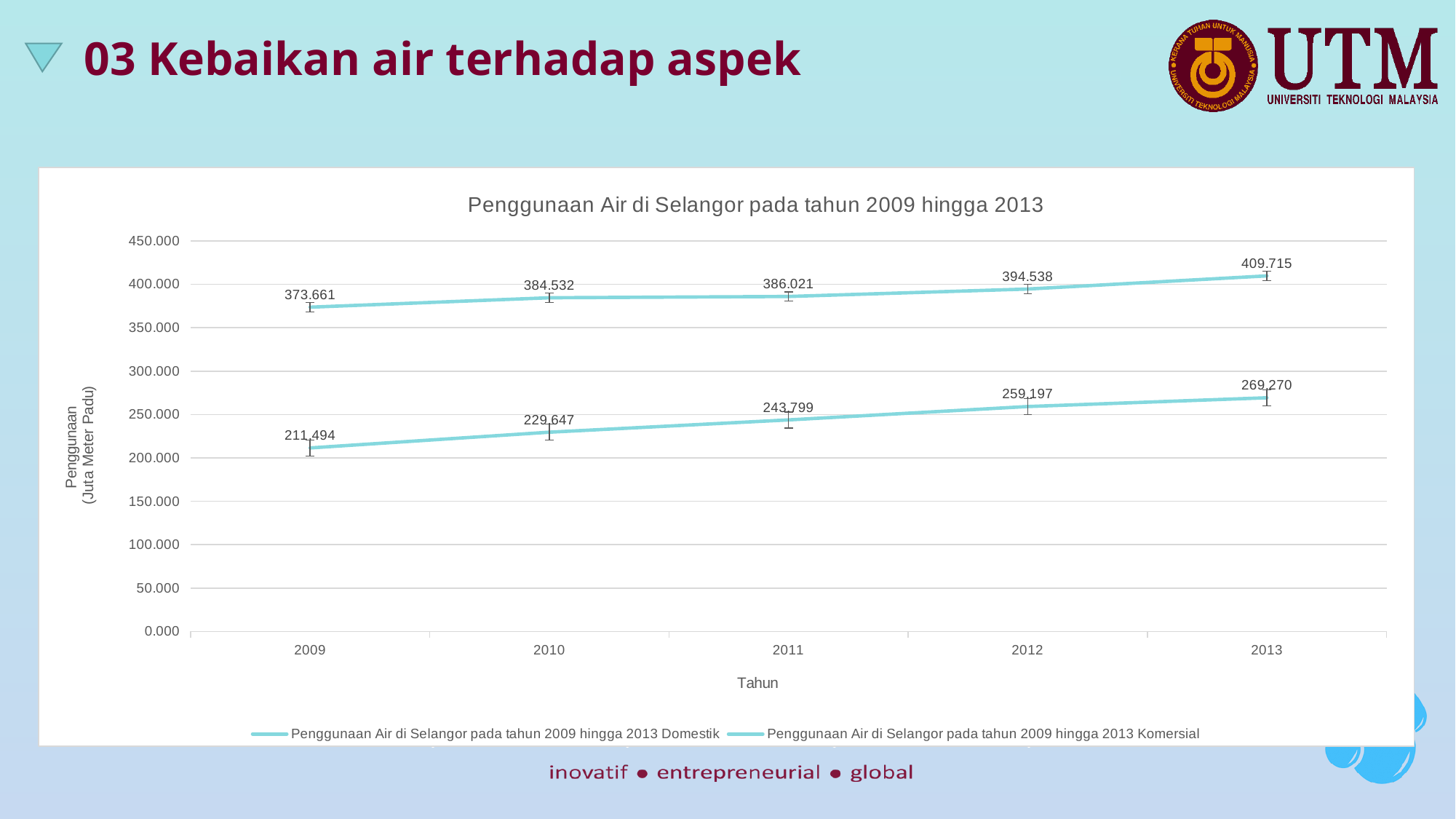
What is the value of the lower line in 2009? 211.494 How many years are plotted along the x axis? 5 How many series does the legend list? 2 What is the title of the chart? Penggunaan Air di Selangor pada tahun 2009 hingga 2013 What kind of chart is shown on the slide? line chart Do the values of the lower line rise or fall from 2009 to 2013? rise What is the value of the lower line in 2011? 243.799 In which year does the upper line reach its highest value? 2013 By how much did the upper line increase from 2009 to 2013? 36.054 What is the difference between the upper line and the lower line in 2012? 135.341 What is the value of the upper line in 2013? 409.715 In which year does the lower line have its lowest value? 2009